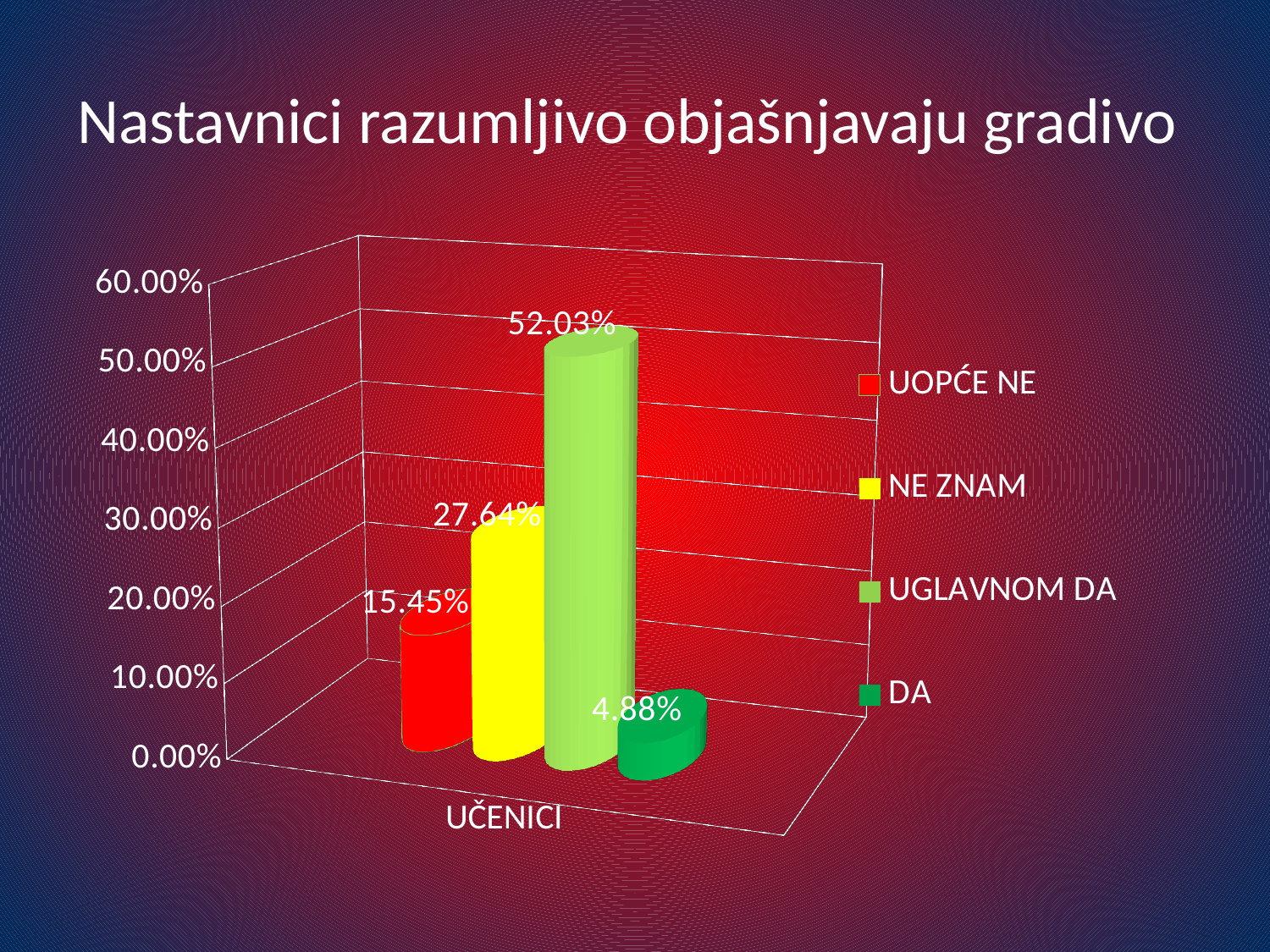
Is the value for UGLAVNOM DA greater or less than 50.00%? greater What is the value for UOPĆE NE? 15.45% How many series does the legend list? 4 Which is larger, the value for NE ZNAM or the value for UOPĆE NE? NE ZNAM Which series has the highest value? UGLAVNOM DA What is the value for NE ZNAM? 27.64% What kind of chart is shown on the slide? bar chart What is the difference between the values for UGLAVNOM DA and NE ZNAM? 24.39% What is the title of the chart? Nastavnici razumljivo objašnjavaju gradivo Which series has the lowest value? DA What is the value for UGLAVNOM DA? 52.03% What is the value for DA? 4.88%